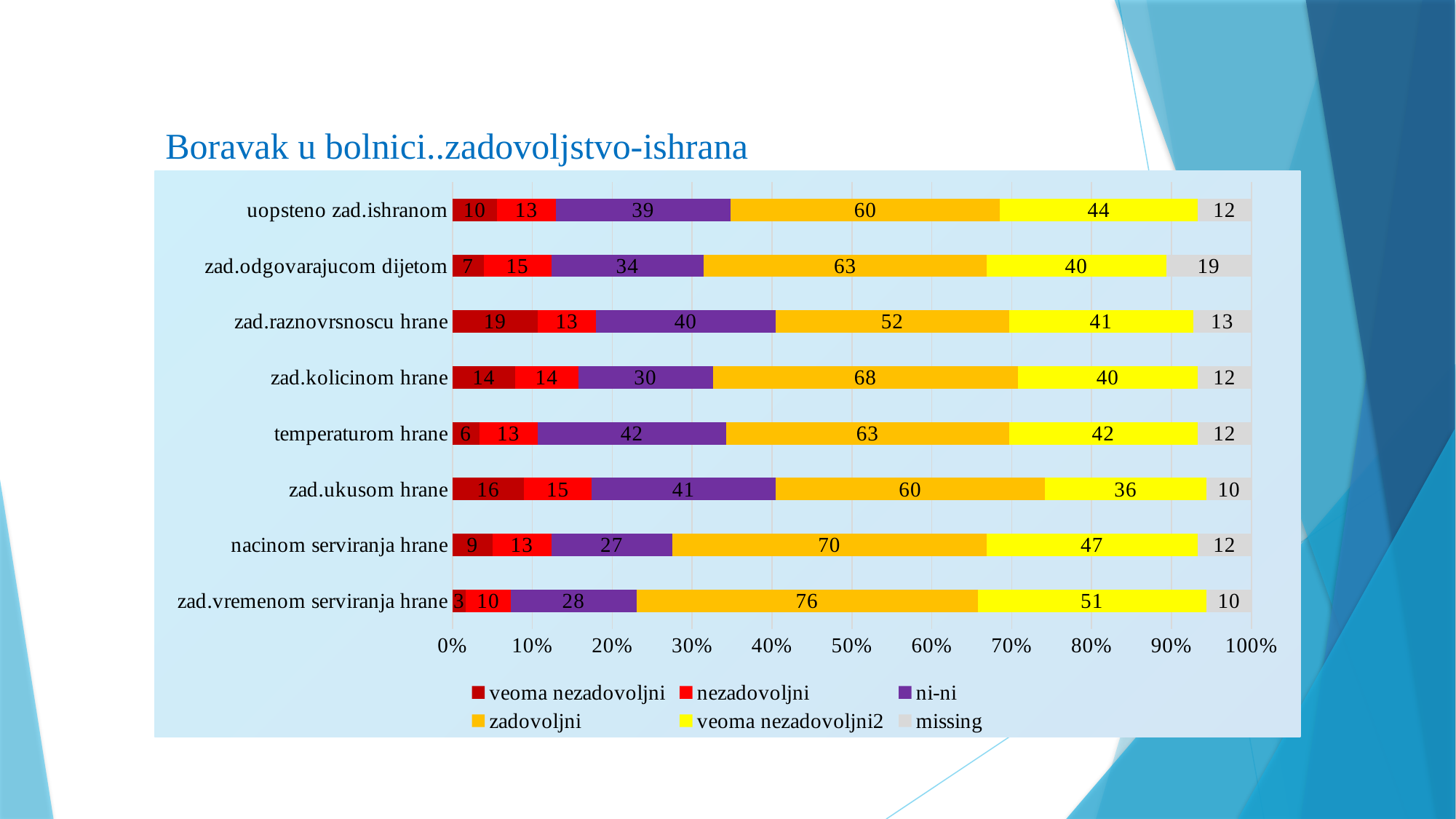
Which has a larger 'ni-ni' value: 'temperaturom hrane' or 'nacinom serviranja hrane'? temperaturom hrane How many series does the legend list? 6 What is the 'ni-ni' value for 'zad.kolicinom hrane'? 30 Which category has the highest 'zadovoljni' value? zad.vremenom serviranja hrane What is the difference between the 'zadovoljni' values for 'nacinom serviranja hrane' and 'zad.kolicinom hrane'? 2 Which category has the highest 'veoma nezadovoljni' value? zad.raznovrsnoscu hrane What kind of chart is shown on the slide? stacked bar chart What is the value of the 'zadovoljni' segment for 'zad.vremenom serviranja hrane'? 76 What is the 'missing' value for 'zad.odgovarajucom dijetom'? 19 Which category has the lowest 'veoma nezadovoljni' value? zad.vremenom serviranja hrane How many categories are shown on the vertical axis of the chart? 8 What is the total of all segments in the 'uopsteno zad.ishranom' bar? 178